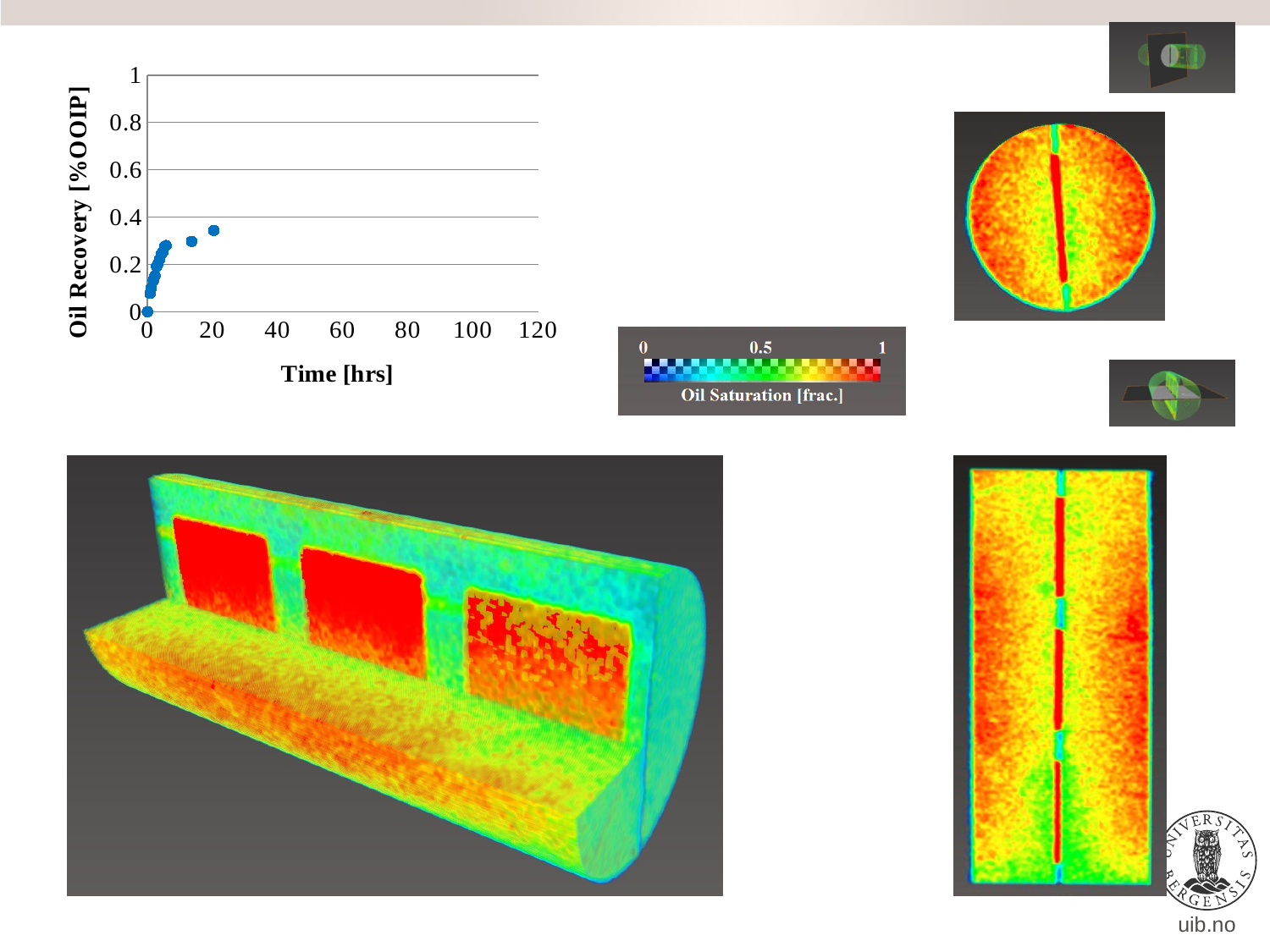
What kind of chart is shown on the slide? scatter chart Is the oil recovery value of the last plotted point (around 20 hrs) greater or less than 0.2? greater What is the title of the x axis of the chart? Time [hrs] What is the largest tick value shown on the y axis of the chart? 1 Are all the plotted points located before the 40 hrs mark on the x axis? yes What is the title of the y axis of the chart? Oil Recovery [%OOIP] What is the largest tick value shown on the x axis of the chart? 120 Is the oil recovery value of the first plotted point at time 0 greater or less than 0.2? less Do the oil recovery values rise or fall as time increases along the x axis? rise